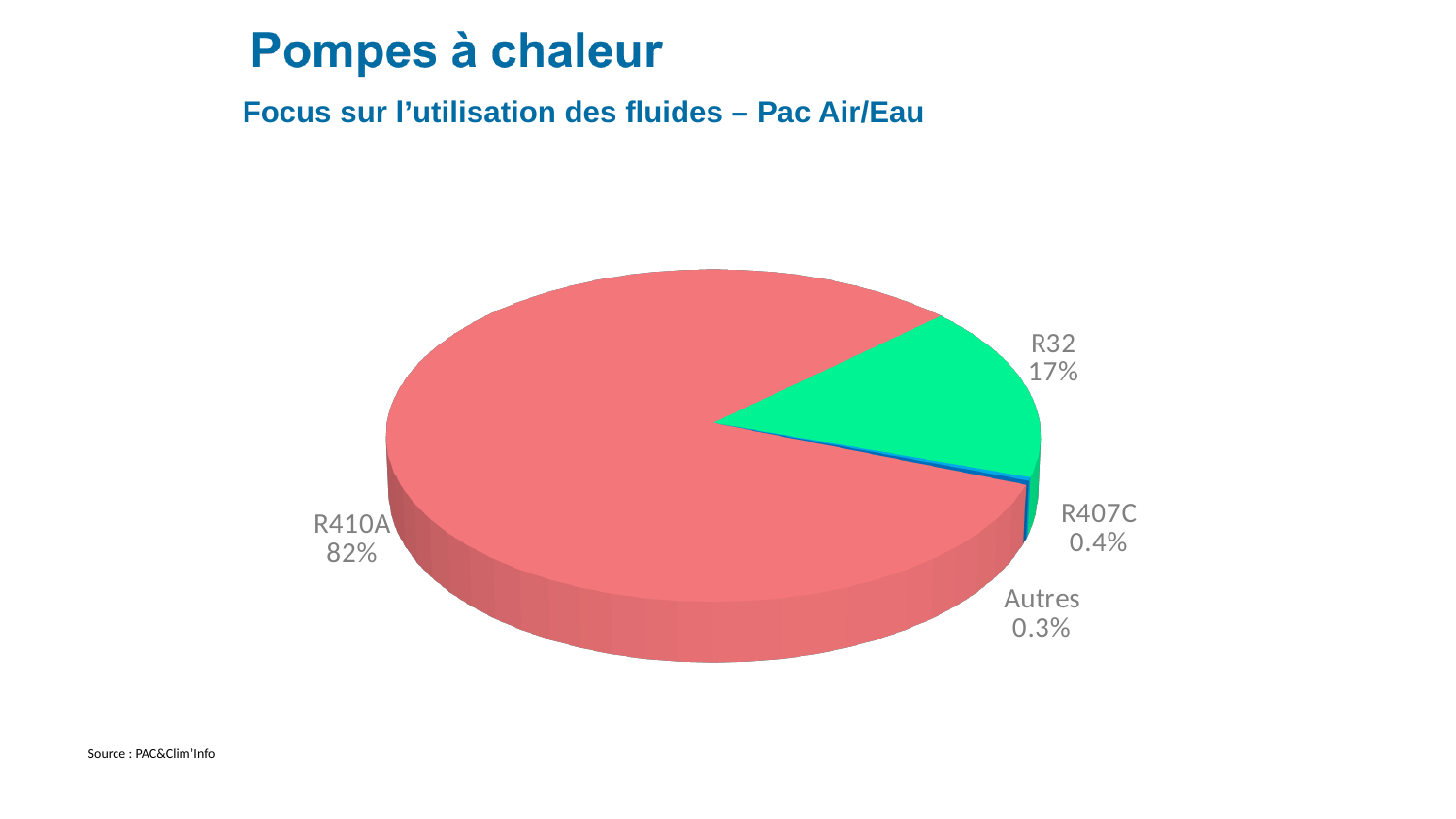
Which category has the smallest slice of the pie? Autres What is the difference between the shares of R410A and R32? 65% What is the value shown for Autres? 0.3% What share of the pie does R410A represent? 82% What kind of chart is shown on the slide? Pie chart What share of the pie does R32 represent? 17% What is the source cited at the bottom of the slide? PAC&Clim'Info Which is larger, the share of R32 or the share of R407C? R32 What colour is the R32 slice? Green What is the value shown for R407C? 0.4% How many categories are shown in the pie chart? 4 Which category has the largest slice of the pie? R410A